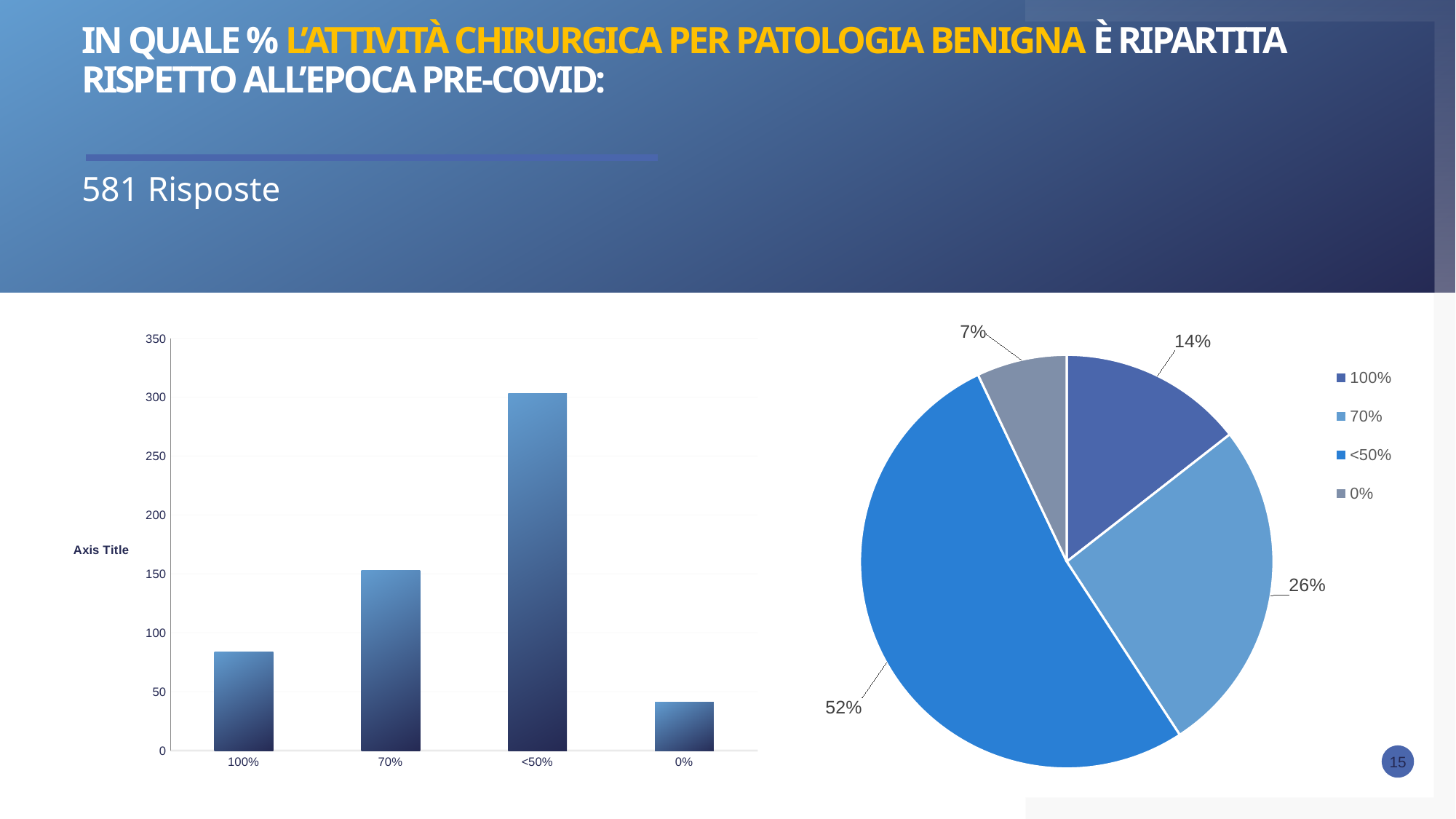
How many entries does the legend of the pie chart on the right list? 4 In the pie chart on the right, what share does the <50% slice have? 52% How many categories are shown in the bar chart on the left? 4 In the bar chart on the left, which is larger, the value for 100% or the value for 70%? 70% In the bar chart on the left, is the value for 100% greater or less than 100? less What kind of chart is the chart on the left of the slide? bar chart In the bar chart on the left, which category has the lowest bar? 0% In the pie chart on the right, what share does the 0% slice have? 7% What kind of chart is the chart on the right of the slide? pie chart In the bar chart on the left, which category has the highest bar? <50%